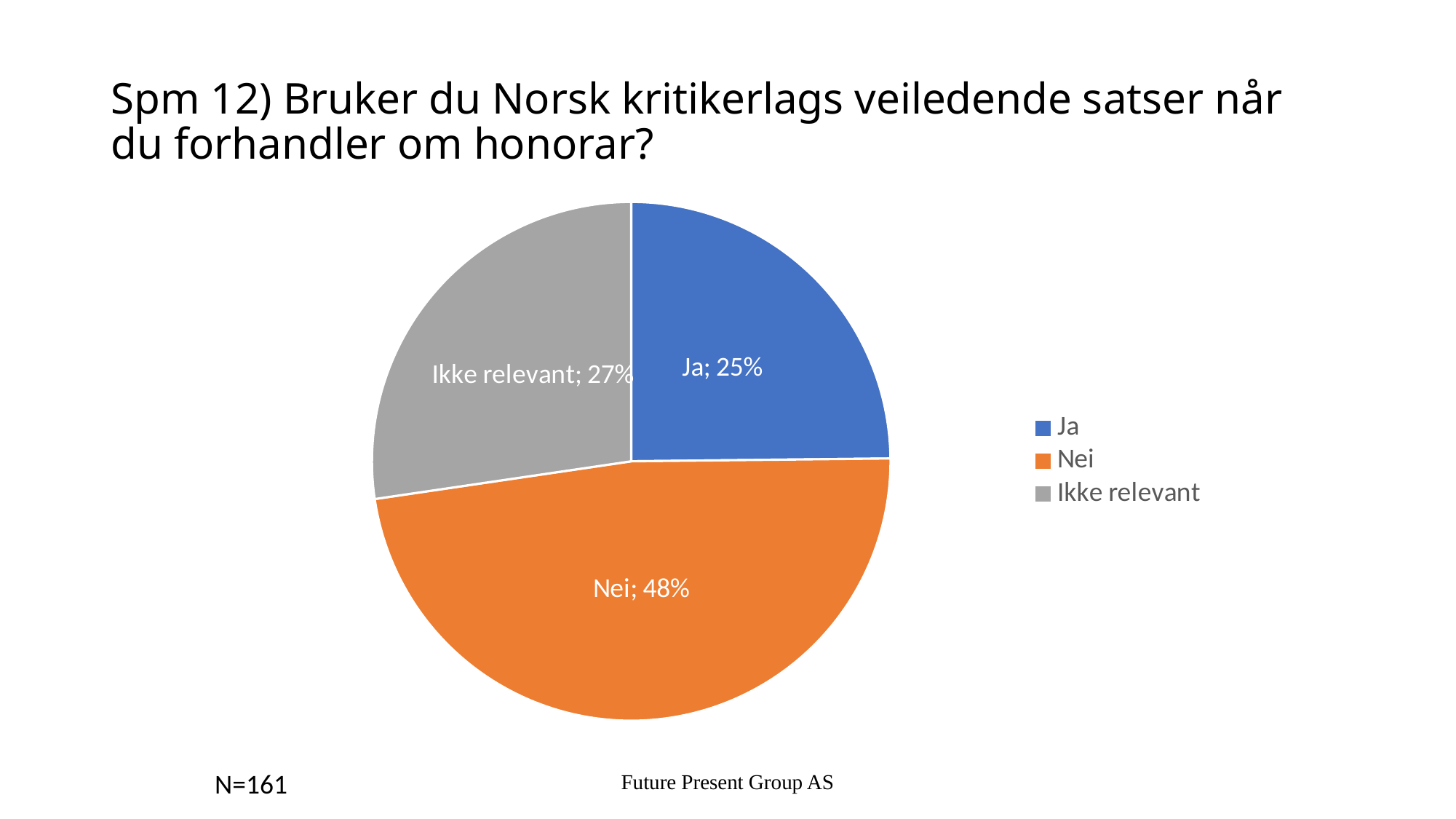
How many slices does the pie chart have? 3 What percentage of respondents answered "Ja"? 25% What percentage of respondents answered "Nei"? 48% What colour is the "Nei" slice? orange How many entries does the legend list? 3 What is the difference in percentage points between "Nei" and "Ja"? 23 Which is larger, the share for "Nei" or the share for "Ikke relevant"? Nei Which category has the smallest share of the pie? Ja What type of chart is shown on the slide? pie chart Which category has the largest share of the pie? Nei What is the difference in percentage points between "Ikke relevant" and "Ja"? 2 What percentage of respondents answered "Ikke relevant"? 27%